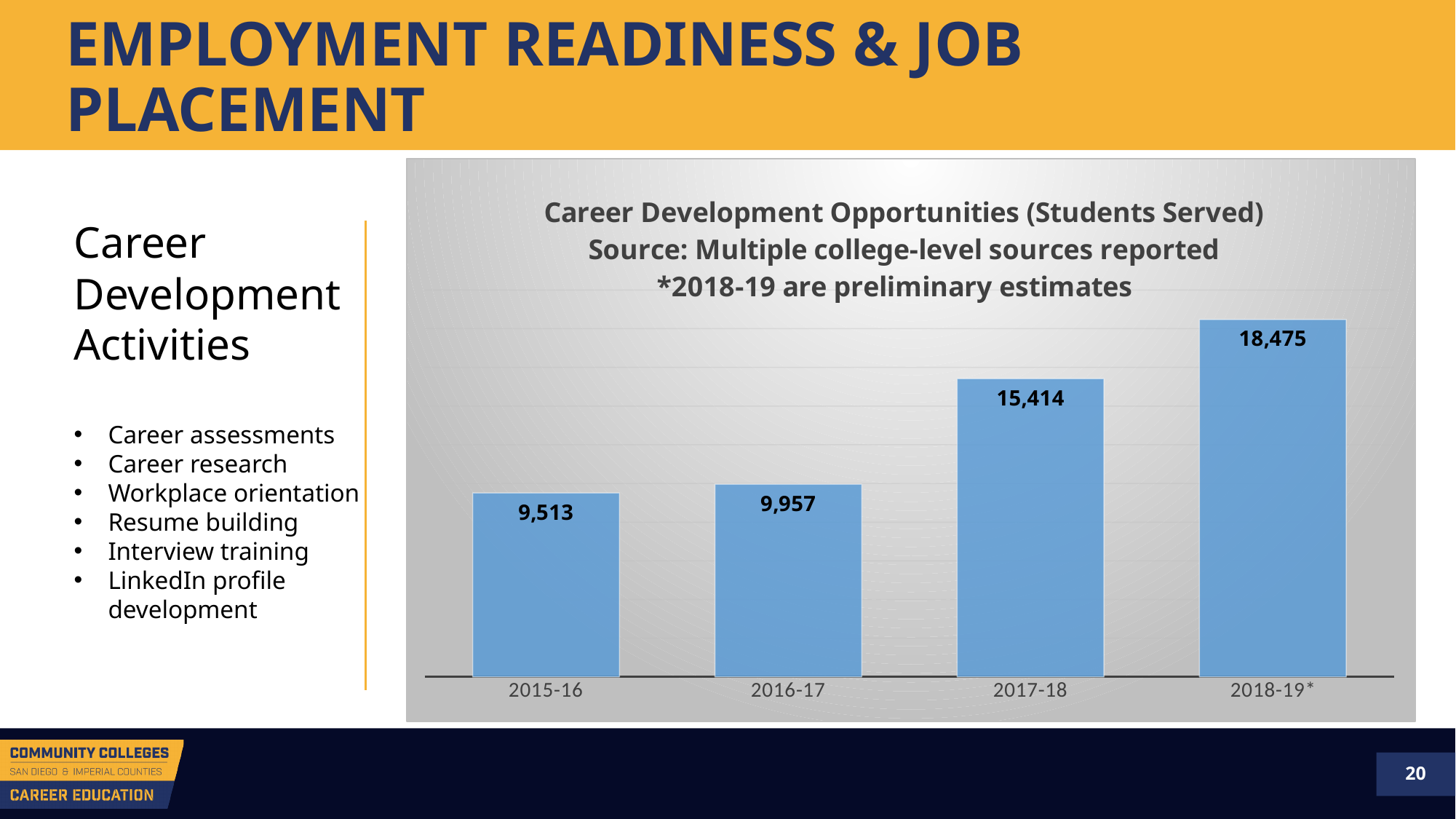
What is the preliminary estimate for 2018-19? 18,475 What is the difference between the 2016-17 and 2015-16 values? 444 Which is larger, the value for 2017-18 or the value for 2016-17? 2017-18 How many students were served in 2017-18? 15,414 Which year has the lowest number of students served? 2015-16 Which year has the highest number of students served? 2018-19* Do the values rise or fall from 2015-16 to 2018-19? Rise How many years are shown on the chart? 4 What is the difference between the 2018-19 and 2017-18 values? 3,061 What kind of chart is shown on the slide? Bar chart What is the value shown for 2016-17? 9,957 How many students were served in 2015-16? 9,513